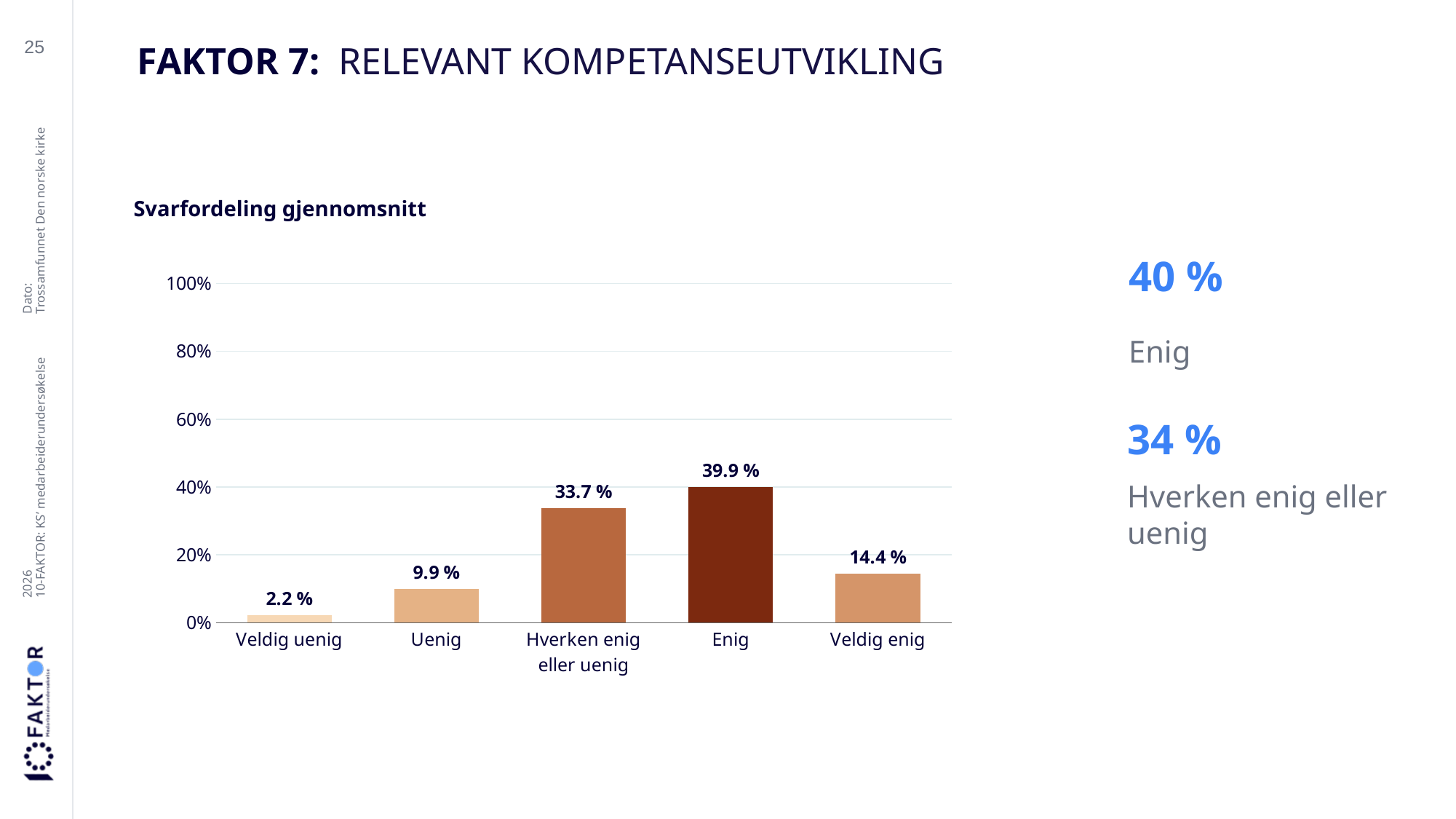
What is the value for Hverken enig eller uenig? 33.7 % Which category has the highest value? Enig What kind of chart is shown on the slide? bar chart Is the value for Enig greater or less than 60%? less What is the value for Enig in the Svarfordeling gjennomsnitt chart? 39.9 % What is the value for Veldig enig? 14.4 % Which category has the lowest value? Veldig uenig Which is larger, the value for Uenig or the value for Veldig enig? Veldig enig What is the difference between the values for Enig and Hverken enig eller uenig? 6.2 % How many categories are shown on the x axis? 5 What is the title of the chart? Svarfordeling gjennomsnitt What is the value for Veldig uenig? 2.2 %